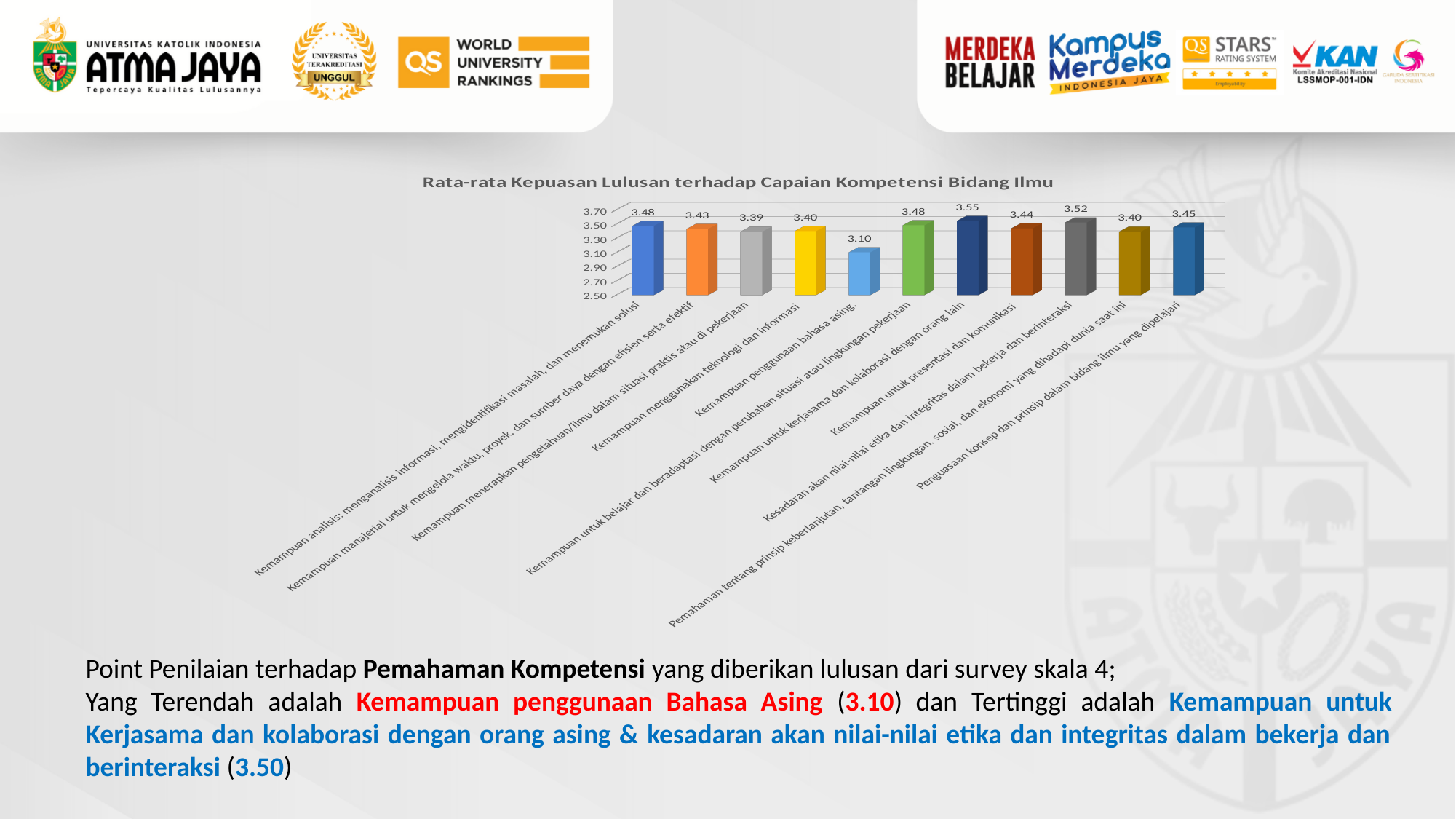
Is the value for 'Kemampuan penggunaan bahasa asing' greater or less than 3.30? less What is the value for 'Kemampuan menggunakan teknologi dan informasi'? 3.40 What is the title of the chart? Rata-rata Kepuasan Lulusan terhadap Capaian Kompetensi Bidang Ilmu What is the value for 'Kemampuan penggunaan bahasa asing'? 3.10 How many categories are plotted in the chart? 11 What is the value for 'Kesadaran akan nilai-nilai etika dan integritas dalam bekerja dan berinteraksi'? 3.52 What is the value for 'Kemampuan untuk kerjasama dan kolaborasi dengan orang lain'? 3.55 Which is larger: the value for 'Kesadaran akan nilai-nilai etika dan integritas dalam bekerja dan berinteraksi' or for 'Kemampuan untuk presentasi dan komunikasi'? Kesadaran akan nilai-nilai etika dan integritas dalam bekerja dan berinteraksi What kind of chart is shown on the slide? Bar chart Which category has the highest value? Kemampuan untuk kerjasama dan kolaborasi dengan orang lain Which category has the lowest value? Kemampuan penggunaan bahasa asing What is the difference between the highest value (3.55) and the lowest value (3.10)? 0.45